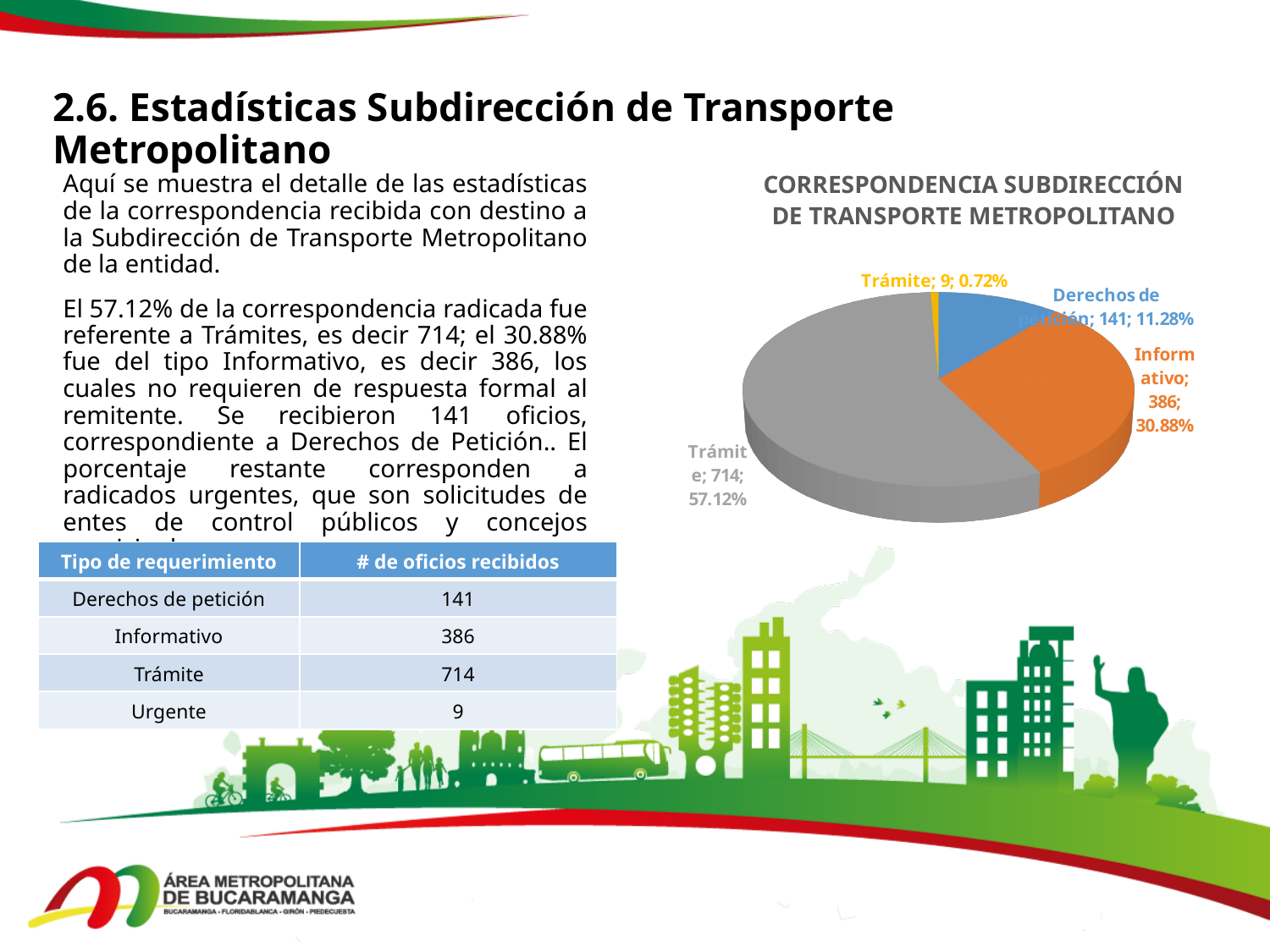
What percentage share does the Informativo slice have? 30.88% What is the number shown for Derechos de petición in the pie chart? 141 What colour is the Informativo slice in the pie chart? Orange What is the value of the smallest slice in the pie chart? 9 What kind of chart is shown on the slide? Pie chart How many slices does the pie chart have? 4 What percentage share does the Derechos de petición slice have? 11.28% What is the difference between the Informativo value and the Derechos de petición value? 245 Which slice is the largest in the pie chart, and what is its share? Trámite; 57.12% What is the number of oficios shown for Informativo in the pie chart? 386 What is the title of the chart? CORRESPONDENCIA SUBDIRECCIÓN DE TRANSPORTE METROPOLITANO Which is larger, the Informativo slice or the Derechos de petición slice? Informativo